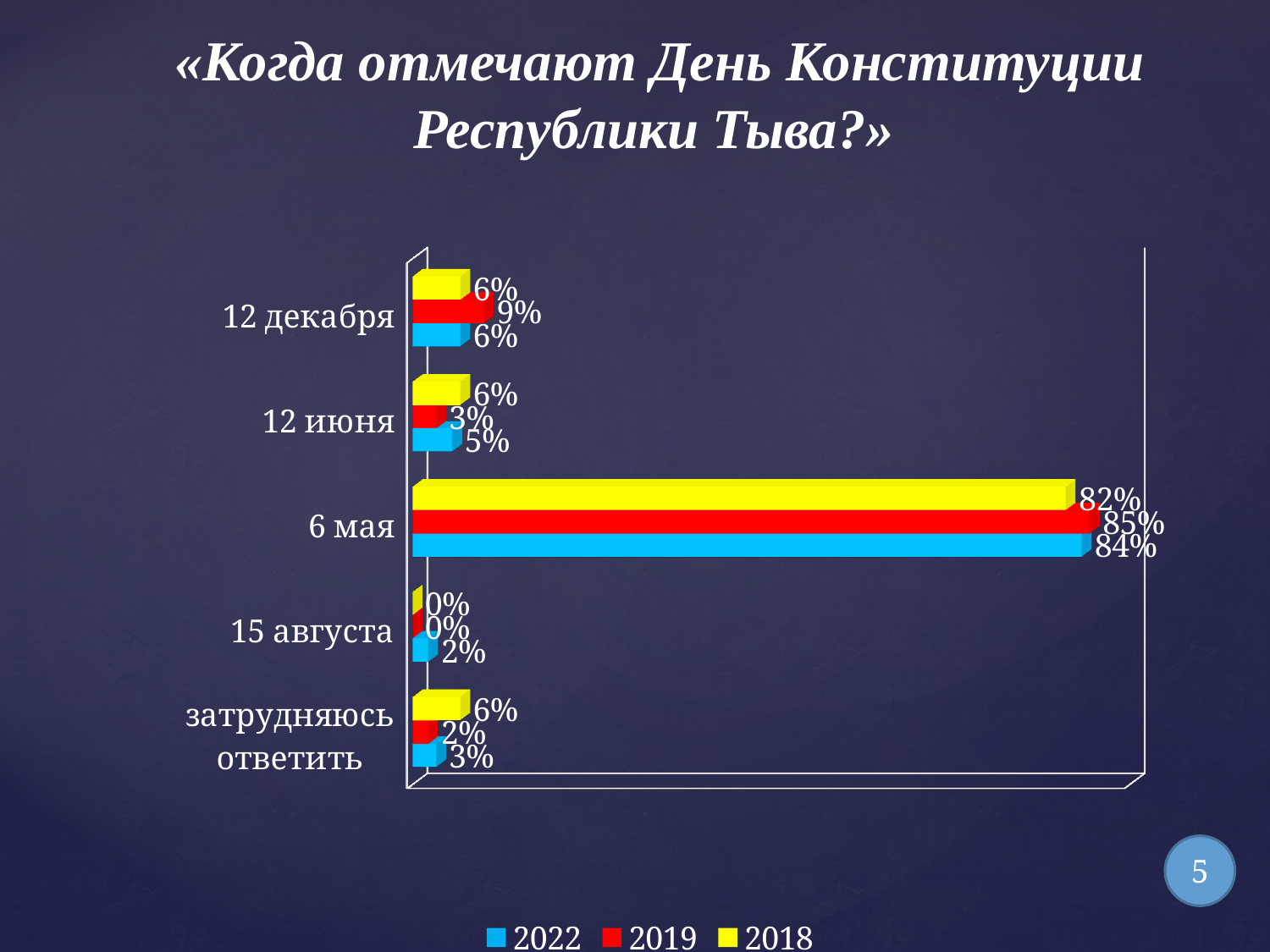
What is the value for "затрудняюсь ответить" in the 2018 series? 6% Which category has the highest value in the 2022 series? 6 мая How many series does the legend list? 3 Which colour represents the 2022 series in the legend? blue What type of chart is shown on the slide? bar chart Which is larger for "12 июня": the 2018 value or the 2019 value? 2018 What is the value for "12 декабря" in the 2019 series? 9% What is the value for "6 мая" in the 2019 series? 85% What is the difference between the 2019 and 2018 values for "6 мая"? 3% Which category has the lowest value in the 2019 series? 15 августа How many answer categories are shown on the chart? 5 What is the value for "15 августа" in the 2022 series? 2%